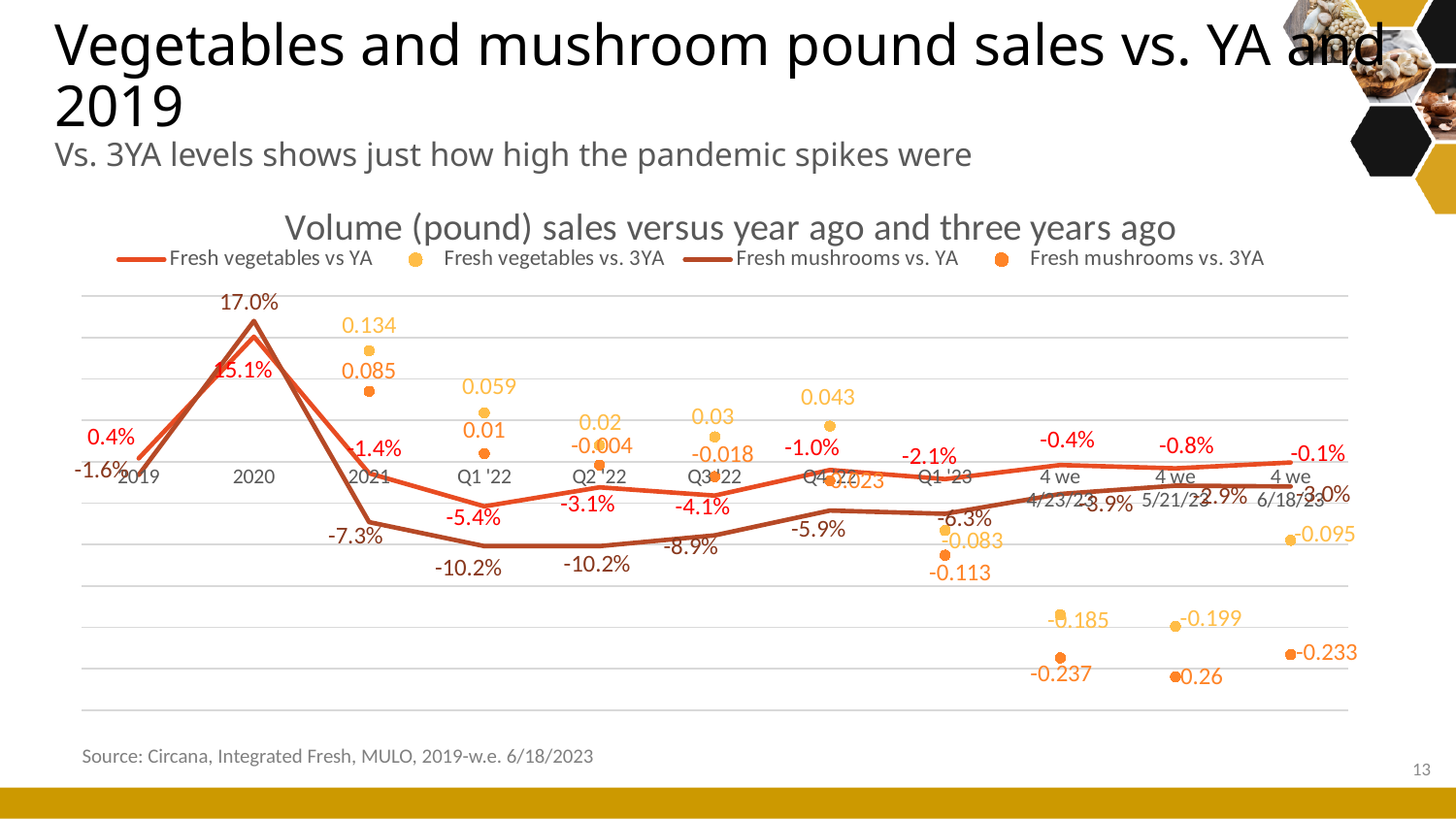
What kind of chart is shown on the slide? line chart What is the Fresh vegetables vs YA value for 2020? 15.1% How many series does the chart legend list? 4 What is the title of the chart? Volume (pound) sales versus year ago and three years ago What is the Fresh mushrooms vs. YA value for 2020? 17.0% How many time periods are shown along the x axis of the chart? 11 What is the Fresh mushrooms vs. YA value for Q1 '22? -10.2% What is the difference between the Fresh mushrooms vs. YA and Fresh vegetables vs YA values in 2020? 1.9 percentage points What is the Fresh vegetables vs. 3YA value for 2021? 0.134 In 2021, which is higher: Fresh vegetables vs YA or Fresh mushrooms vs. YA? Fresh vegetables vs YA In which period does Fresh mushrooms vs. YA reach its highest value? 2020 What is the Fresh mushrooms vs. 3YA value for the 4 weeks ending 5/21/23? -0.26